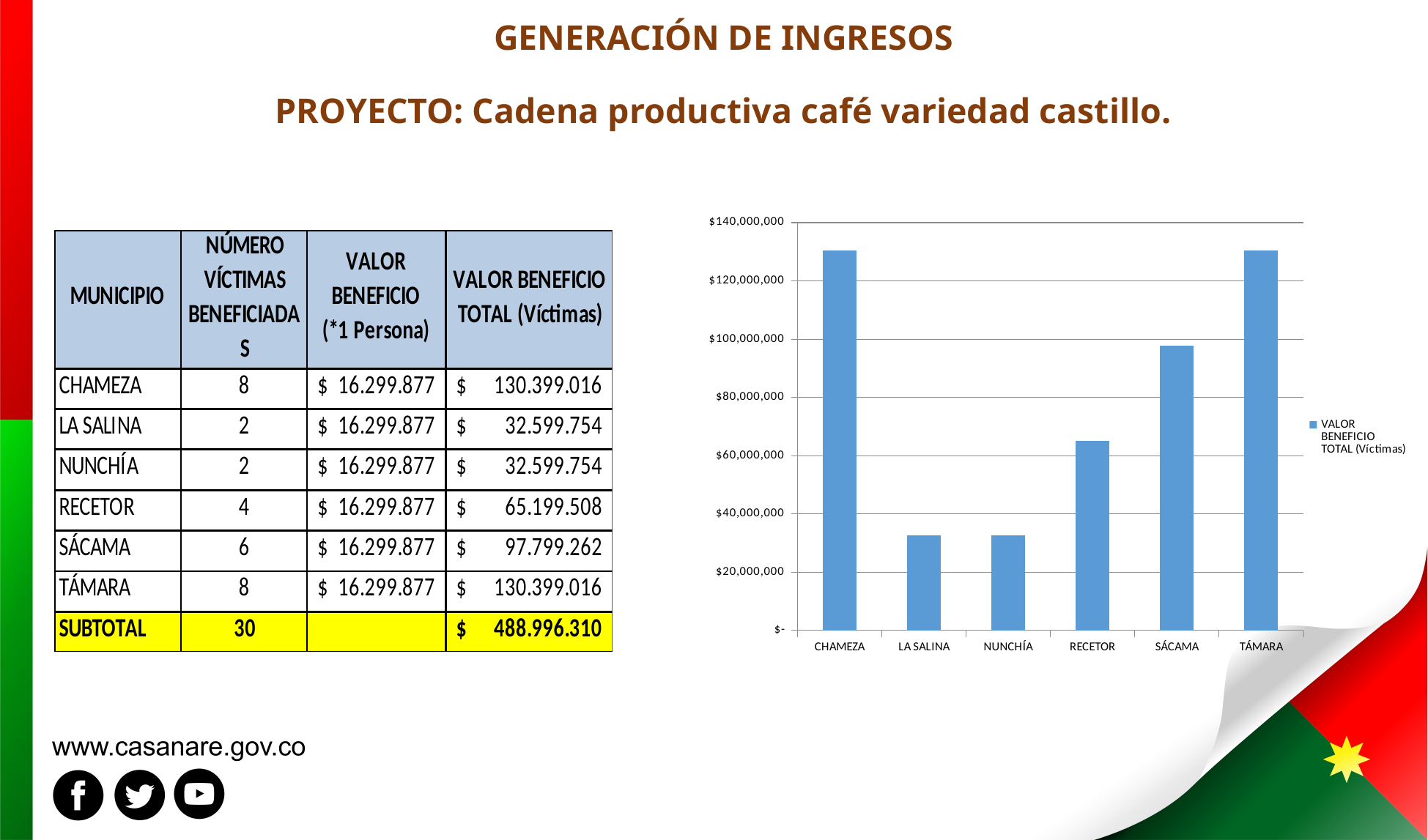
Which two municipalities share the lowest bar in the chart? LA SALINA and NUNCHÍA Is the value for LA SALINA in the chart greater or less than $20,000,000? greater Which has the larger value in the chart, SÁCAMA or RECETOR? SÁCAMA What is the legend entry of the chart? VALOR BENEFICIO TOTAL (Víctimas) Using the values in the table, what is the difference between the VALOR BENEFICIO TOTAL for CHAMEZA and for SÁCAMA? $ 32.599.754 How many series does the chart legend list? 1 Is the value for RECETOR in the chart greater or less than $60,000,000? greater Is the value for SÁCAMA in the chart greater or less than $100,000,000? less According to the table on the slide, what is the VALOR BENEFICIO TOTAL (Víctimas) for RECETOR? $ 65.199.508 What kind of chart is shown on the slide? bar chart How many municipalities are plotted on the x axis of the chart? 6 Which two municipalities share the highest bar in the chart? CHAMEZA and TÁMARA